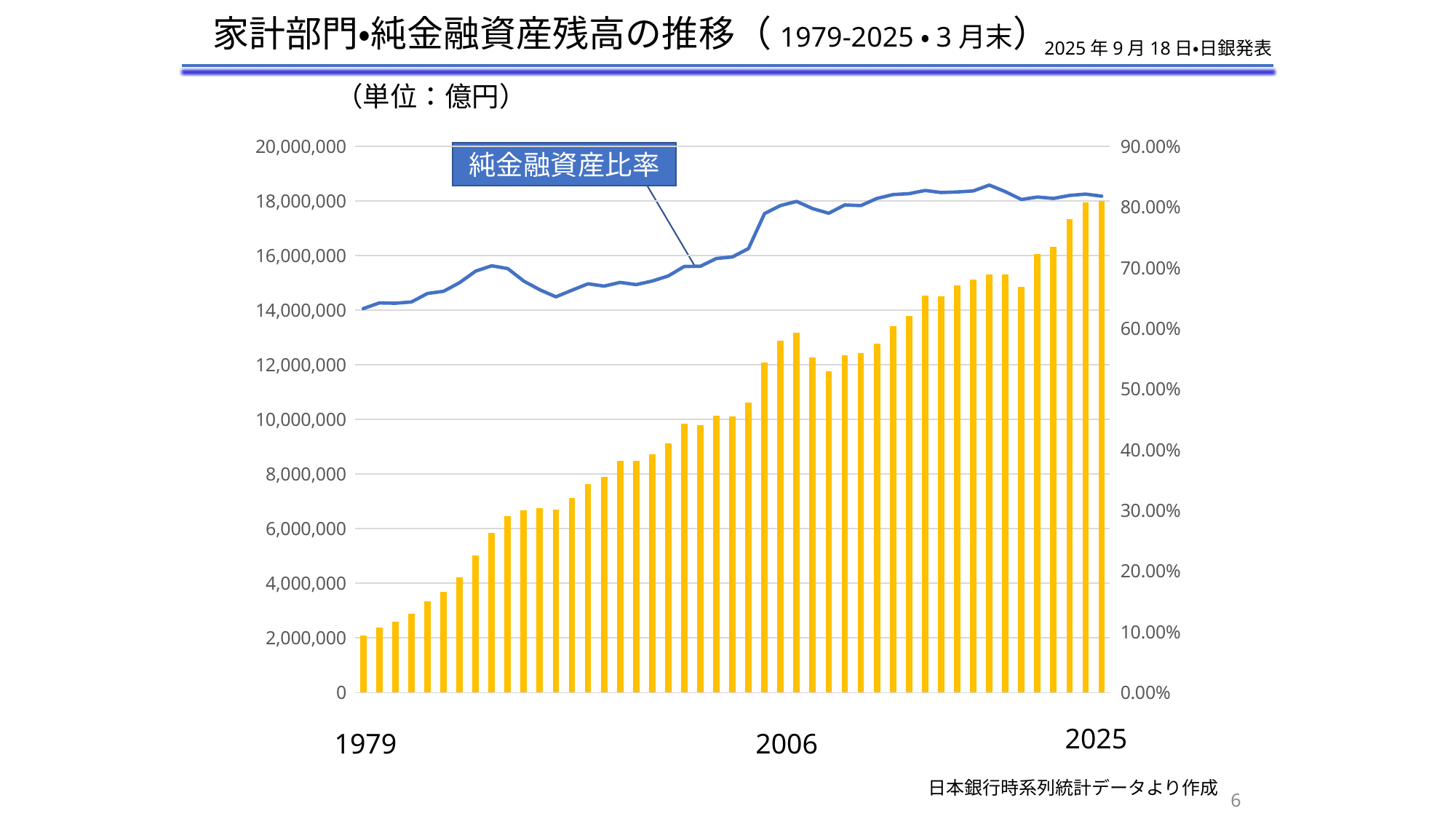
Do the bar values generally rise or fall from 1979 to 2025? rise Is the bar for 2025 greater or less than 16,000,000? greater Which year has the lowest bar (net financial asset balance)? 1979 Is the bar for 1979 greater or less than 4,000,000? less Is the 純金融資産比率 line value for 2025 greater or less than 70.00%? greater Which is larger, the bar for 1979 or the bar for 2025? 2025 Which year has the highest bar (net financial asset balance)? 2025 What kind of chart is shown on the slide? A bar chart combined with a line chart What does the blue line on the chart represent, according to the label on the slide? 純金融資産比率 What is the title of the chart? 家計部門•純金融資産残高の推移（1979-2025・3月末） What is the highest value shown on the right-hand (percentage) axis? 90.00%